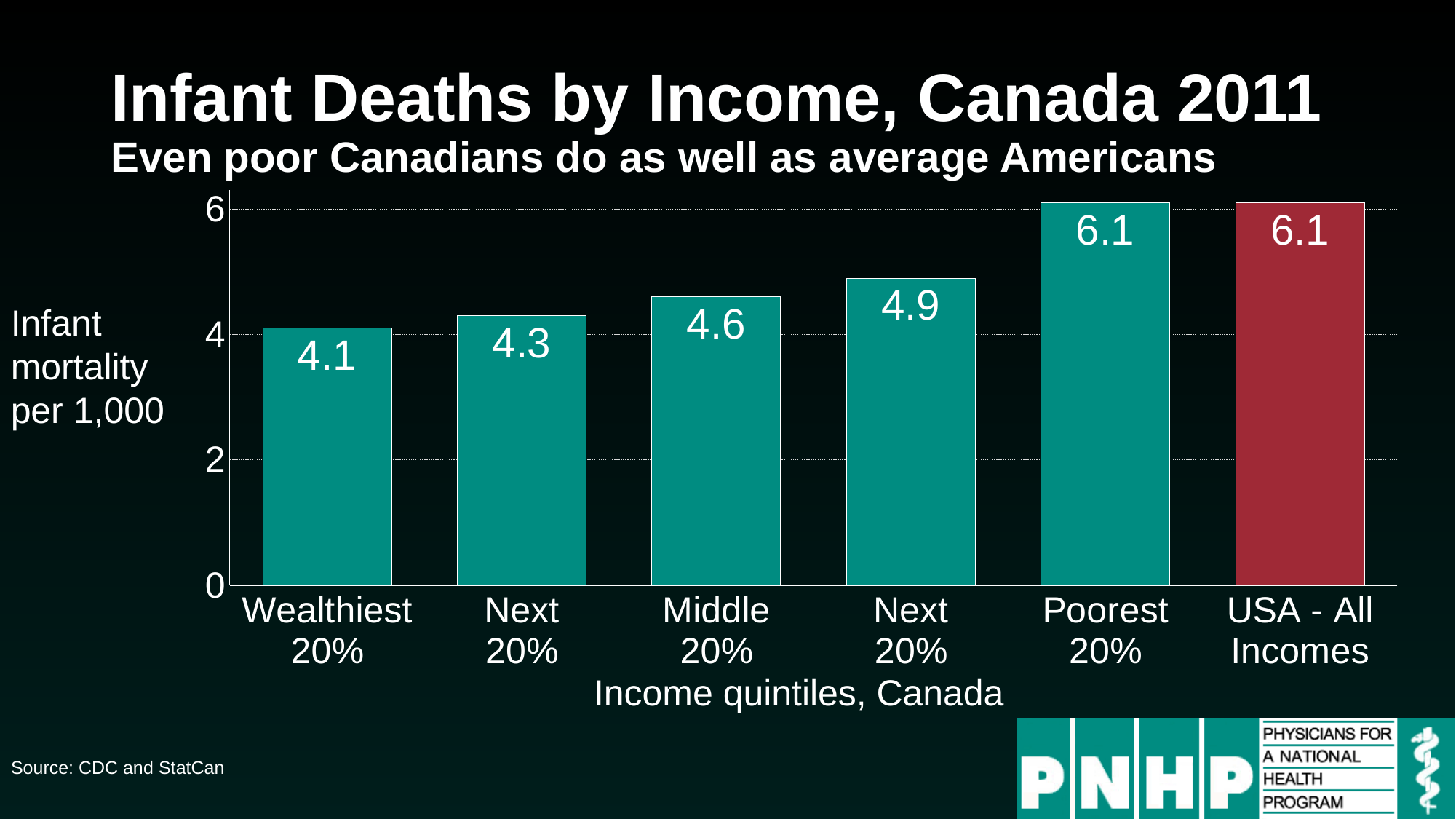
What is the difference in infant mortality between the Poorest 20% and the Wealthiest 20% in Canada? 2.0 Is the value for the Poorest 20% greater or less than 6? greater Which category has the lowest infant mortality rate? Wealthiest 20% What is the infant mortality rate for the Middle 20% income quintile? 4.6 How many bars are shown in the chart? 6 Which is larger, the value for the Middle 20% or the value for the Wealthiest 20%? Middle 20% What is the infant mortality rate shown for USA - All Incomes? 6.1 What value is shown on the second bar from the left (the Next 20% after the Wealthiest)? 4.3 What is the difference between the Middle 20% and the Wealthiest 20% values? 0.5 What is the infant mortality rate for the Wealthiest 20% in Canada? 4.1 What type of chart is shown on the slide? Bar chart What is the infant mortality rate for the Poorest 20% in Canada? 6.1